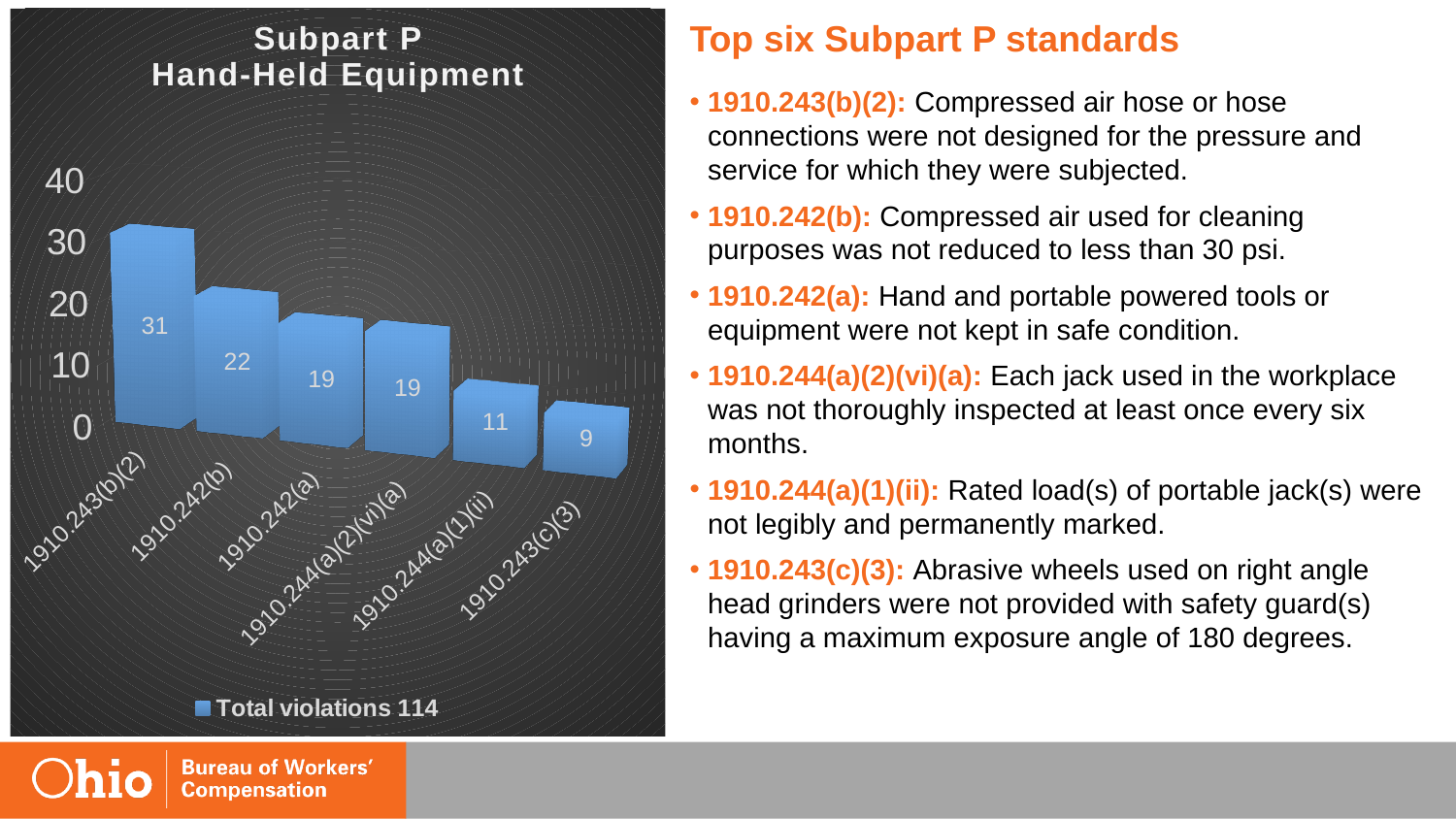
How many categories are shown in the chart? 6 What is the value for 1910.243(c)(3)? 9 What is the legend entry of the chart? Total violations 114 Which category has the lowest value? 1910.243(c)(3) Do the values rise or fall from left to right along the x axis? fall Is the value for 1910.243(b)(2) greater or less than 20? greater What is the difference between the values for 1910.243(b)(2) and 1910.242(b)? 9 What is the value for 1910.242(b)? 22 Which is larger, the value for 1910.244(a)(1)(ii) or the value for 1910.243(c)(3)? 1910.244(a)(1)(ii) What is the value for 1910.243(b)(2)? 31 Which category has the highest value? 1910.243(b)(2) What kind of chart is shown? bar chart